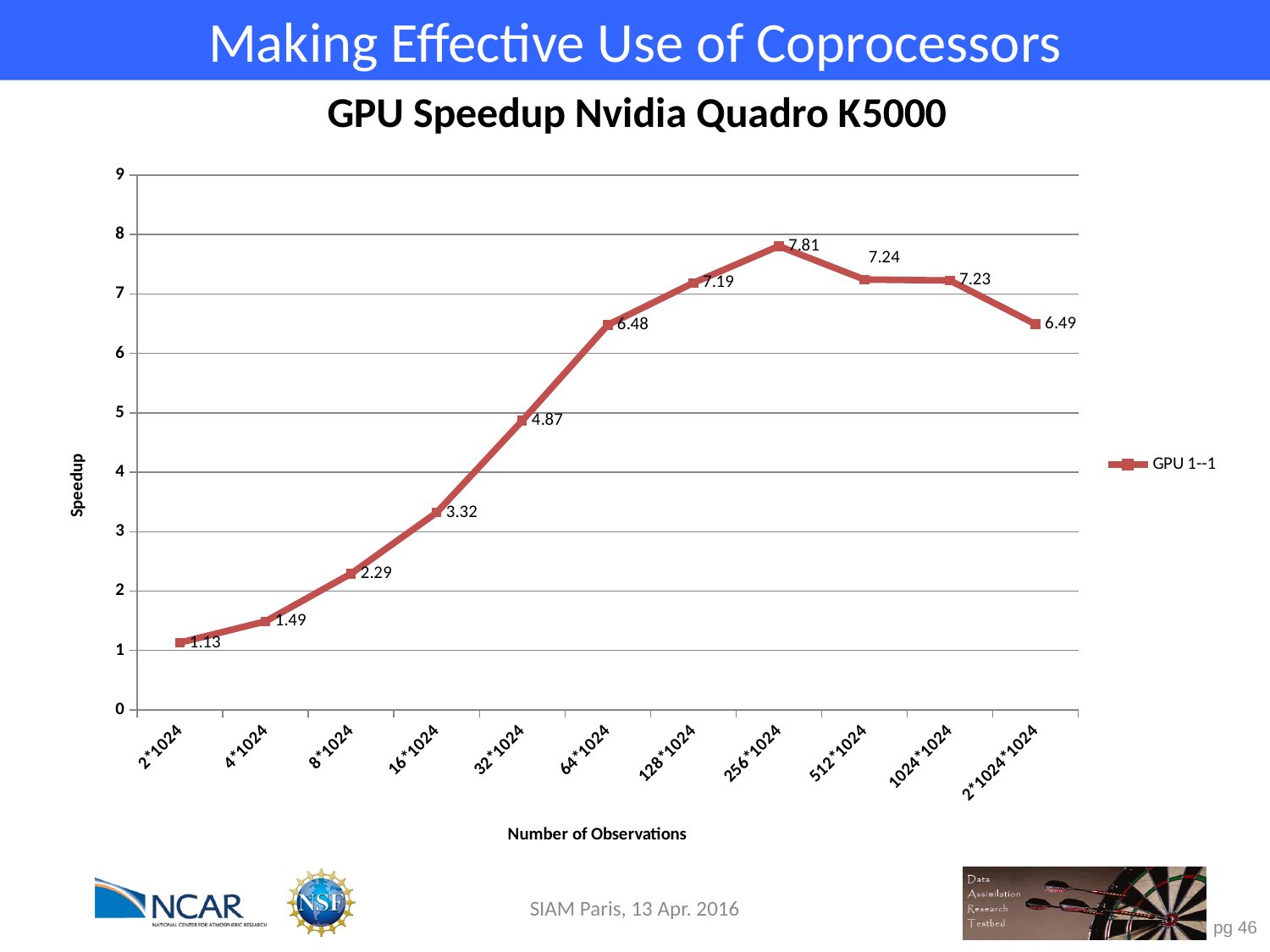
At which number of observations is the GPU speedup lowest? 2*1024 Which has a larger speedup, 64*1024 or 128*1024 observations? 128*1024 Is the speedup at 16*1024 observations greater or less than 3? greater What is the GPU speedup at 32*1024 observations? 4.87 What is the difference in speedup between 256*1024 and 2*1024*1024 observations? 1.32 What is the title of the chart? GPU Speedup Nvidia Quadro K5000 How many data points are plotted on the line? 11 What is the GPU speedup at 256*1024 observations? 7.81 What is the GPU speedup at 2*1024 observations? 1.13 What kind of chart is shown on the slide? line chart How many series does the legend list? 1 At which number of observations is the GPU speedup highest? 256*1024